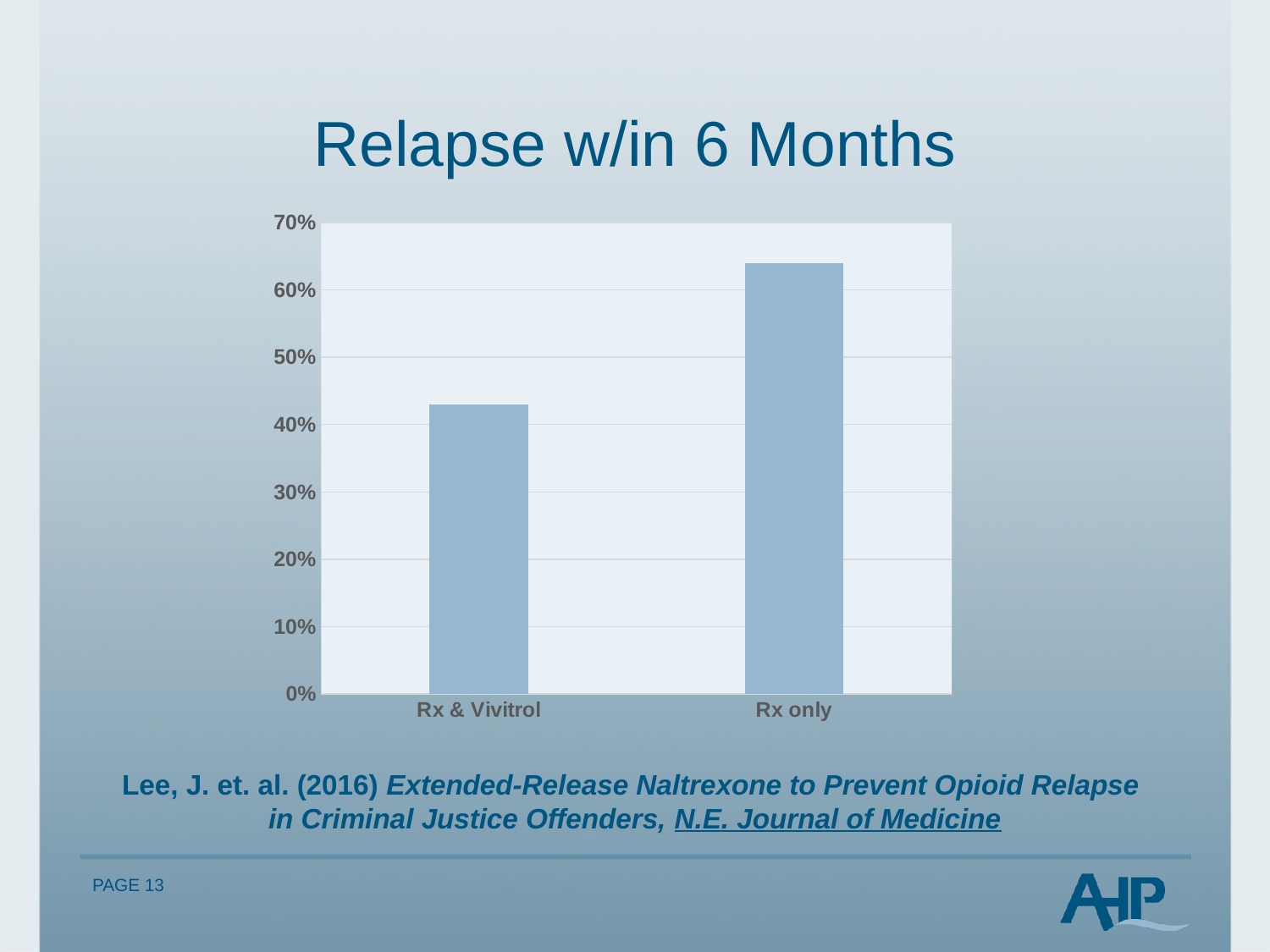
Which category has the lowest relapse rate in the chart? Rx & Vivitrol Which is larger, the value for Rx & Vivitrol or the value for Rx only? Rx only Which category has the highest relapse rate in the chart? Rx only What is the title of the chart on the slide? Relapse w/in 6 Months Is the value for Rx only greater or less than 70%? less What kind of chart is shown on the slide? bar chart Is the value for Rx & Vivitrol greater or less than 40%? greater How many categories are shown on the x axis of the chart? 2 Is the value for Rx & Vivitrol greater or less than 50%? less Do the values rise or fall from Rx & Vivitrol to Rx only along the x axis? rise What is the highest value shown on the y axis of the chart? 70%